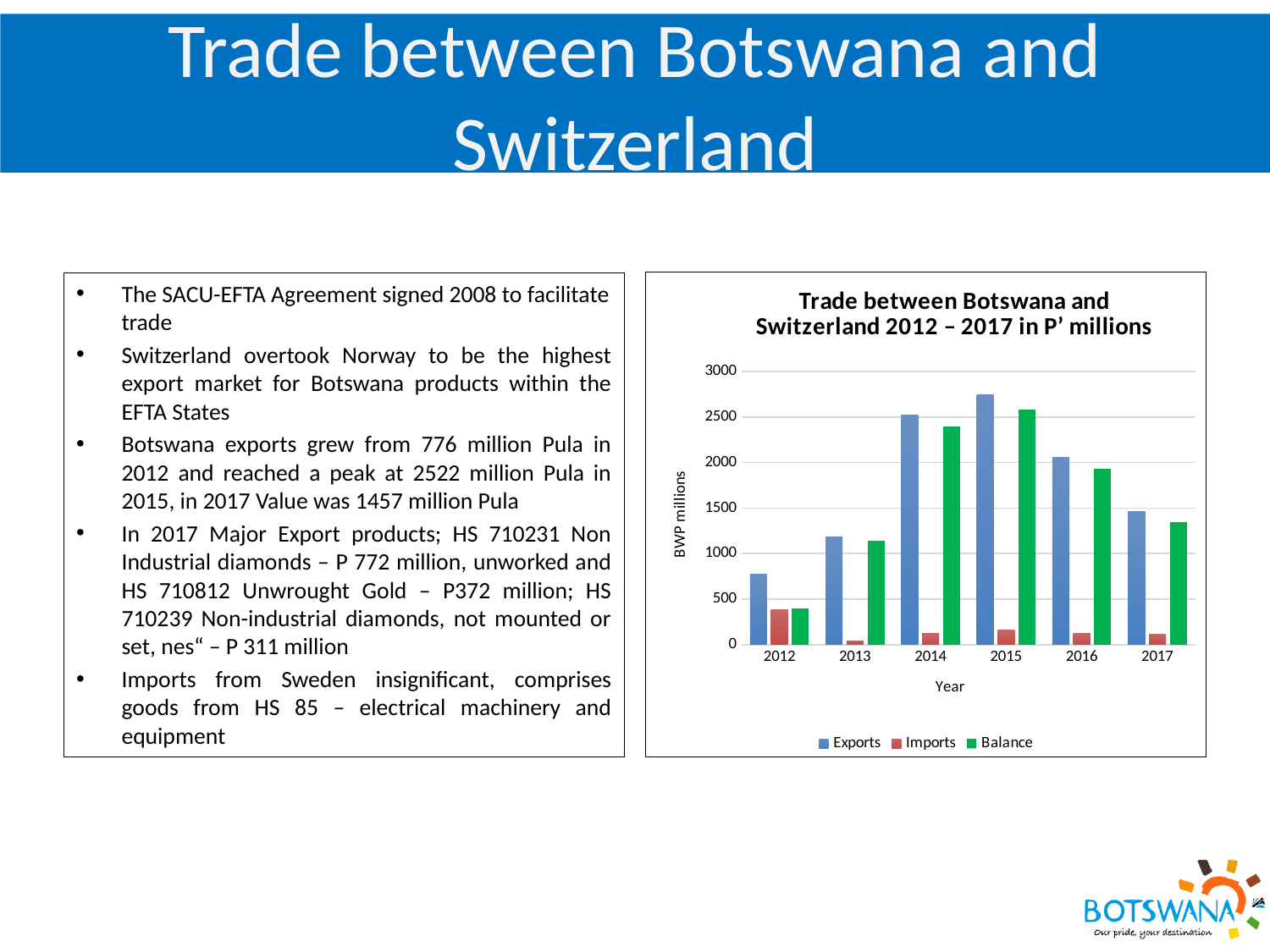
Is the value for Imports in 2012 greater or less than 500? less What is the label on the vertical axis of the chart? BWP millions In which year are Imports highest? 2012 In which year is the Balance lowest? 2012 How many years are shown on the x axis of the chart? 6 What kind of chart is shown on the slide? bar chart Is the value for Exports in 2015 greater or less than 2500? greater Is the value for Exports in 2012 greater or less than 1000? less How many series does the chart legend list? 3 In which year are Exports highest? 2015 Which is larger, Exports in 2014 or Exports in 2016? Exports in 2014 In which year are Exports lowest? 2012